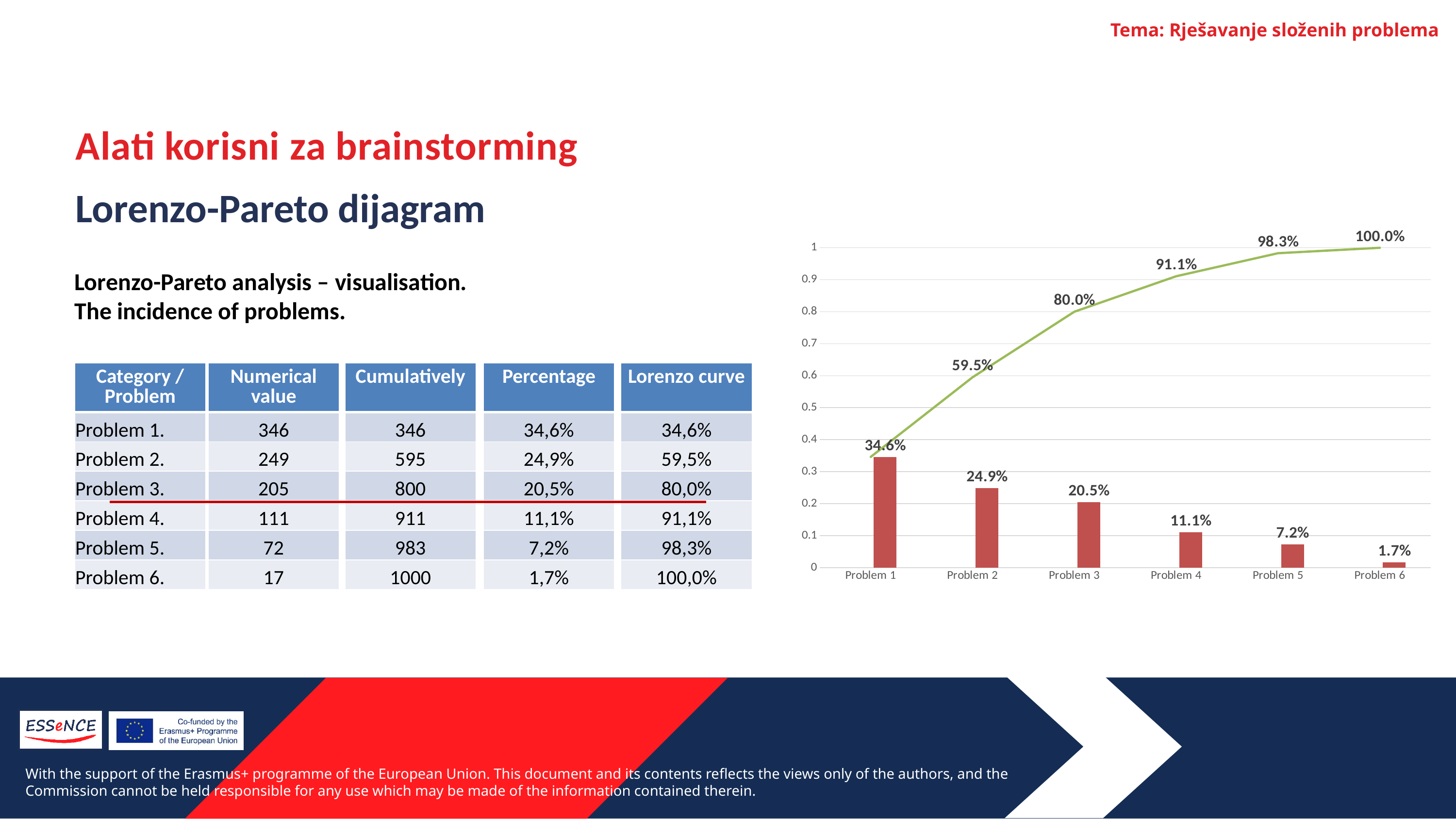
What kind of chart is shown on the slide? Combined bar and line chart What is the bar value for Problem 1? 34.6% Which problem has the highest bar? Problem 1 Which problem has the lowest bar? Problem 6 What is the difference between the bar values for Problem 2 and Problem 3? 4.4% Do the bar values rise or fall from Problem 1 to Problem 6? fall How many problem categories are shown on the x axis? 6 What is the cumulative line value at Problem 5? 98.3% Is the cumulative line value at Problem 2 greater or less than 0.5? greater What is the cumulative line value at Problem 3? 80.0% Which has a larger bar value, Problem 4 or Problem 5? Problem 4 What is the bar value for Problem 4? 11.1%